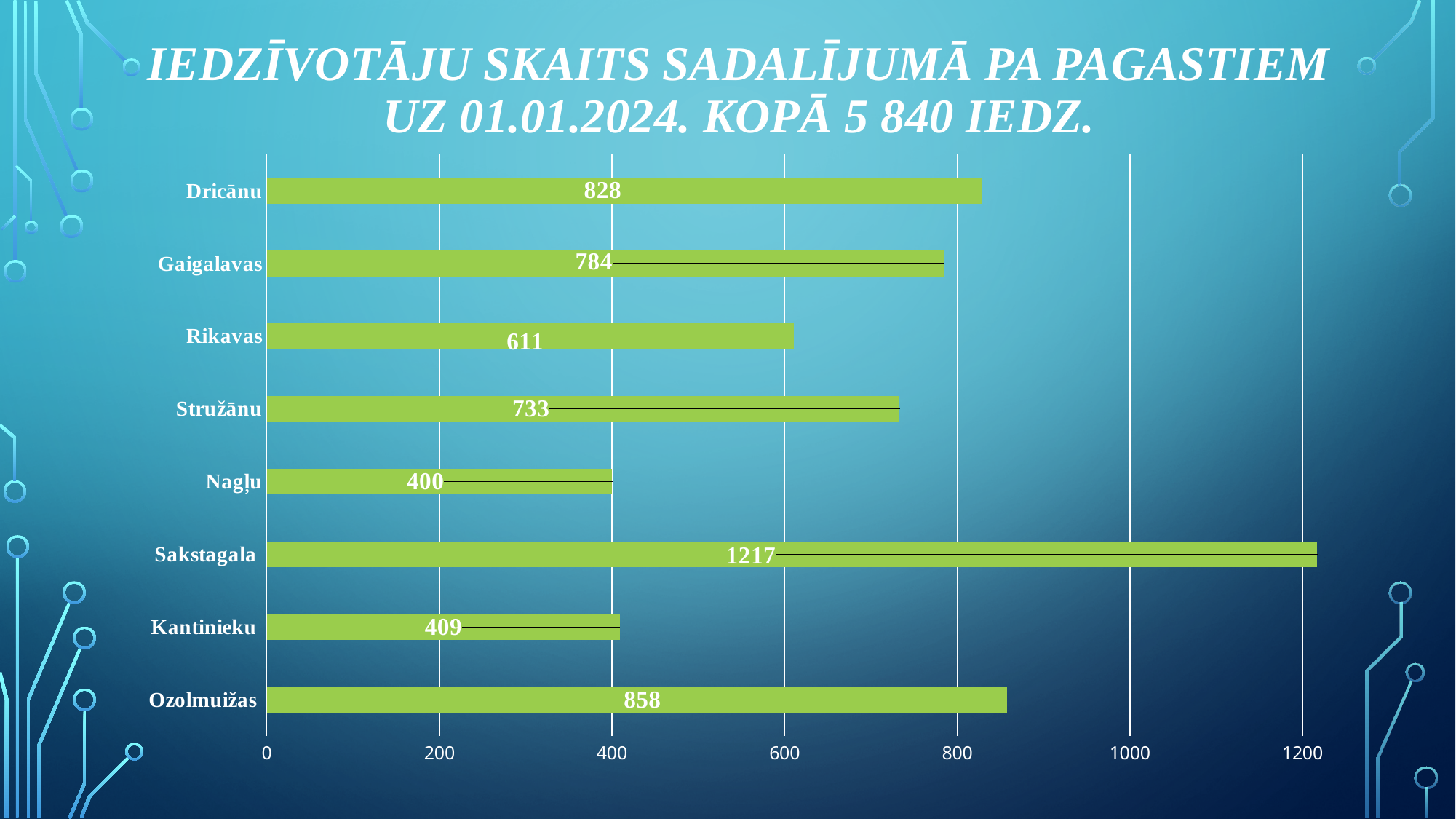
What is the difference between the values for Dricānu and Gaigalavas? 44 What is the difference between the values for Sakstagala and Nagļu? 817 Is the value for Kantinieku greater or less than 600? less What is the population value shown for Sakstagala? 1217 What is the population value shown for Nagļu? 400 What total population is stated in the slide title? 5 840 Which parish has the highest population in the chart? Sakstagala What is the population value shown for Ozolmuižas? 858 Which parish has the lowest population in the chart? Nagļu Which has a larger value, Rikavas or Stružānu? Stružānu What kind of chart is shown on the slide? bar chart How many parishes are shown in the chart? 8